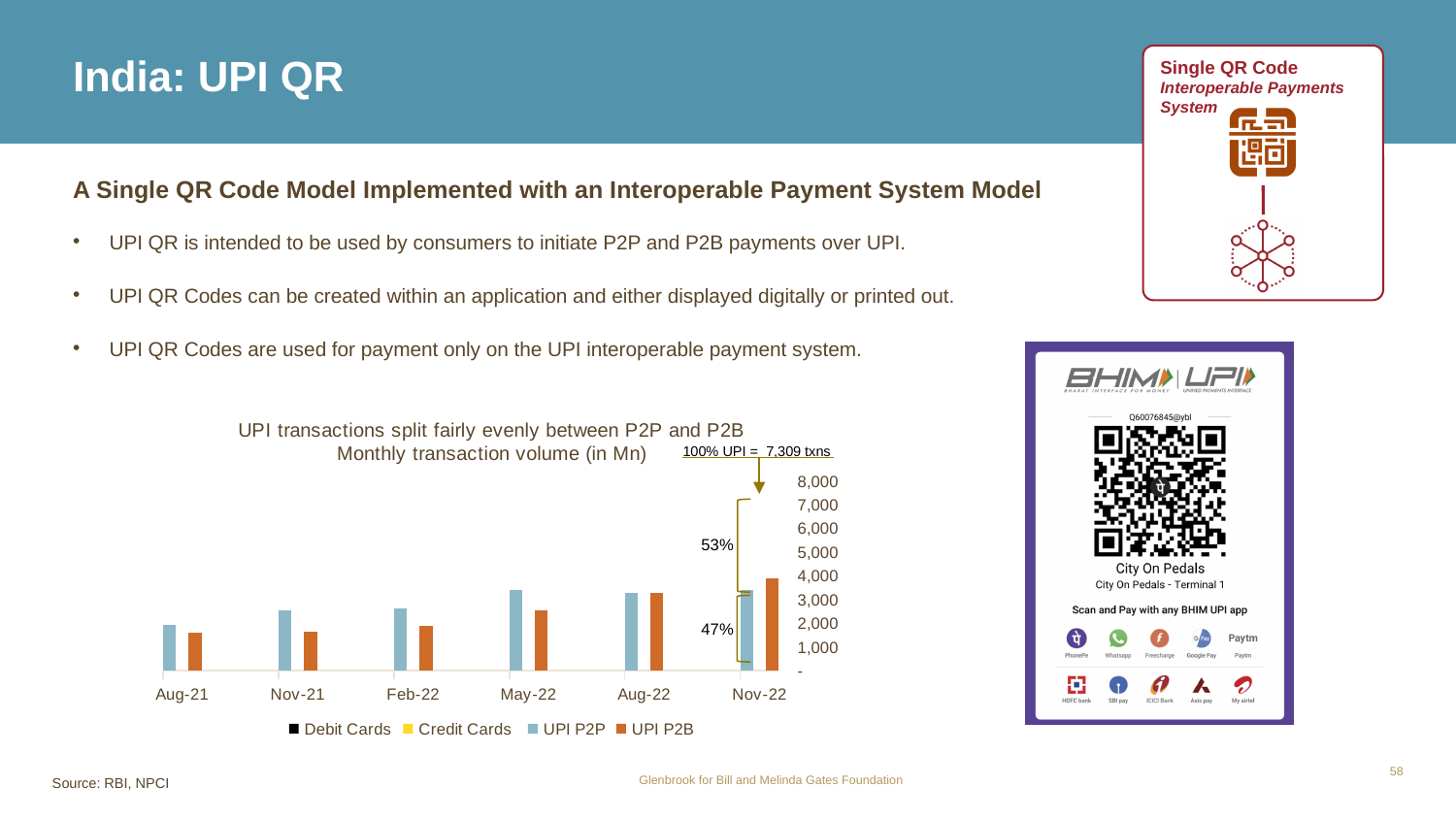
Which period has the lowest UPI P2P volume? Aug-21 How many series does the chart legend list? 4 Does the UPI P2B volume generally rise or fall from Aug-21 to Nov-22? Rise What share of Nov-22 UPI transactions is UPI P2B, according to the chart annotation? 53% Which period has the highest UPI P2B volume? Nov-22 What type of chart is shown on the slide? Bar chart Is the UPI P2P value for Aug-21 greater or less than 3,000? less Is the UPI P2B value for Nov-22 greater or less than 3,000? greater According to the annotation on the chart, what is the total UPI transaction volume (100% UPI) for Nov-22? 7,309 txns How many time periods are shown on the x axis of the chart? 6 What share of Nov-22 UPI transactions is UPI P2P, according to the chart annotation? 47% In Nov-22, which is larger: UPI P2P or UPI P2B? UPI P2B